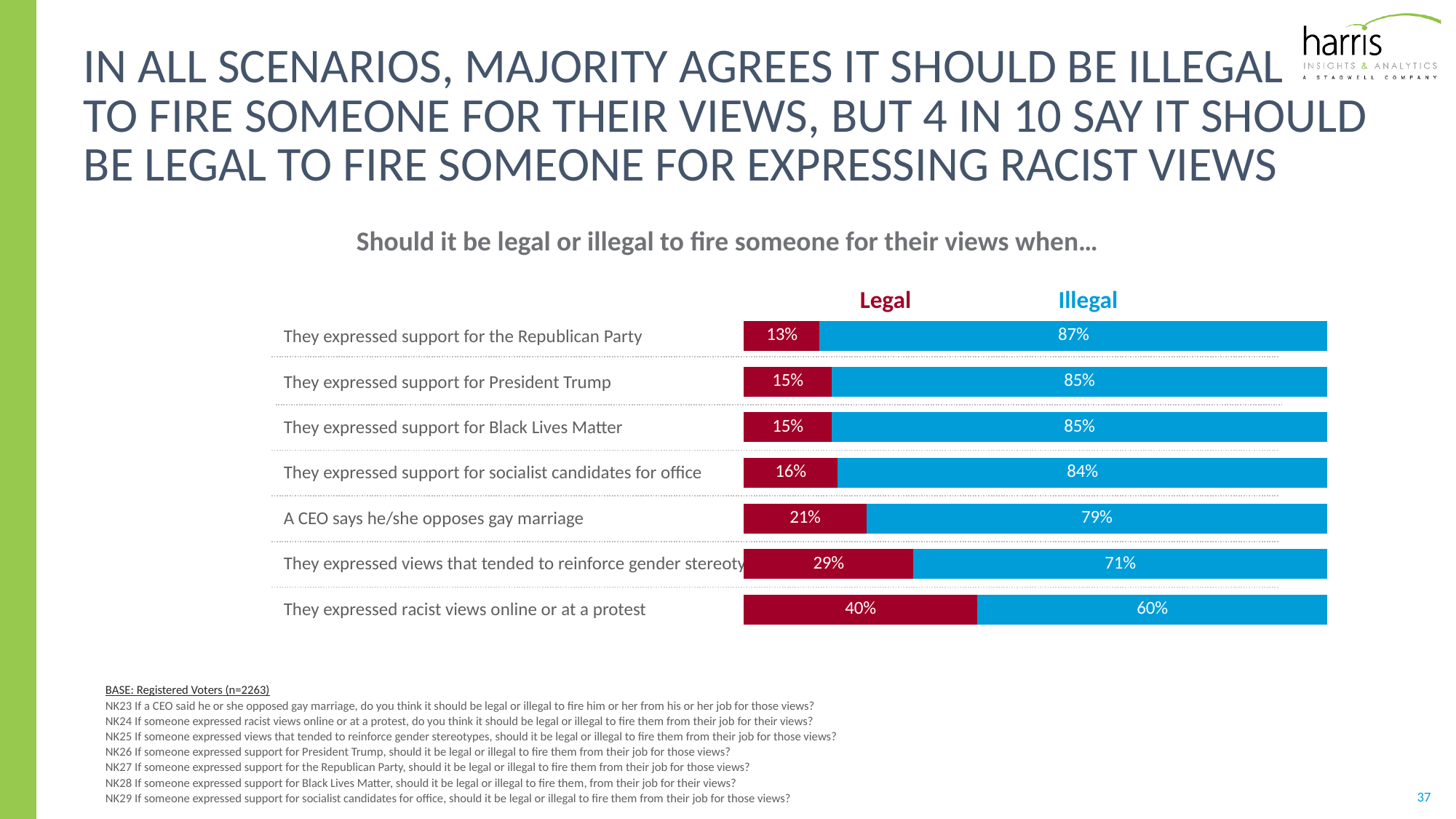
How many series does the chart show? 2 What is the difference between the Illegal values for 'They expressed support for President Trump' and 'They expressed racist views online or at a protest'? 25% What is the Legal value for 'A CEO says he/she opposes gay marriage'? 21% Which scenario has the highest Legal percentage? They expressed racist views online or at a protest What colour represents the Illegal series? Blue What type of chart is shown on the slide? Stacked bar chart What percentage say it should be illegal to fire someone who expressed support for the Republican Party? 87% Which has a larger Legal value: 'A CEO says he/she opposes gay marriage' or 'They expressed support for Black Lives Matter'? A CEO says he/she opposes gay marriage What is the Illegal value for 'They expressed support for socialist candidates for office'? 84% How many scenarios are shown in the chart? 7 What percentage say it should be legal to fire someone who expressed racist views online or at a protest? 40% Which scenario has the lowest Legal percentage? They expressed support for the Republican Party